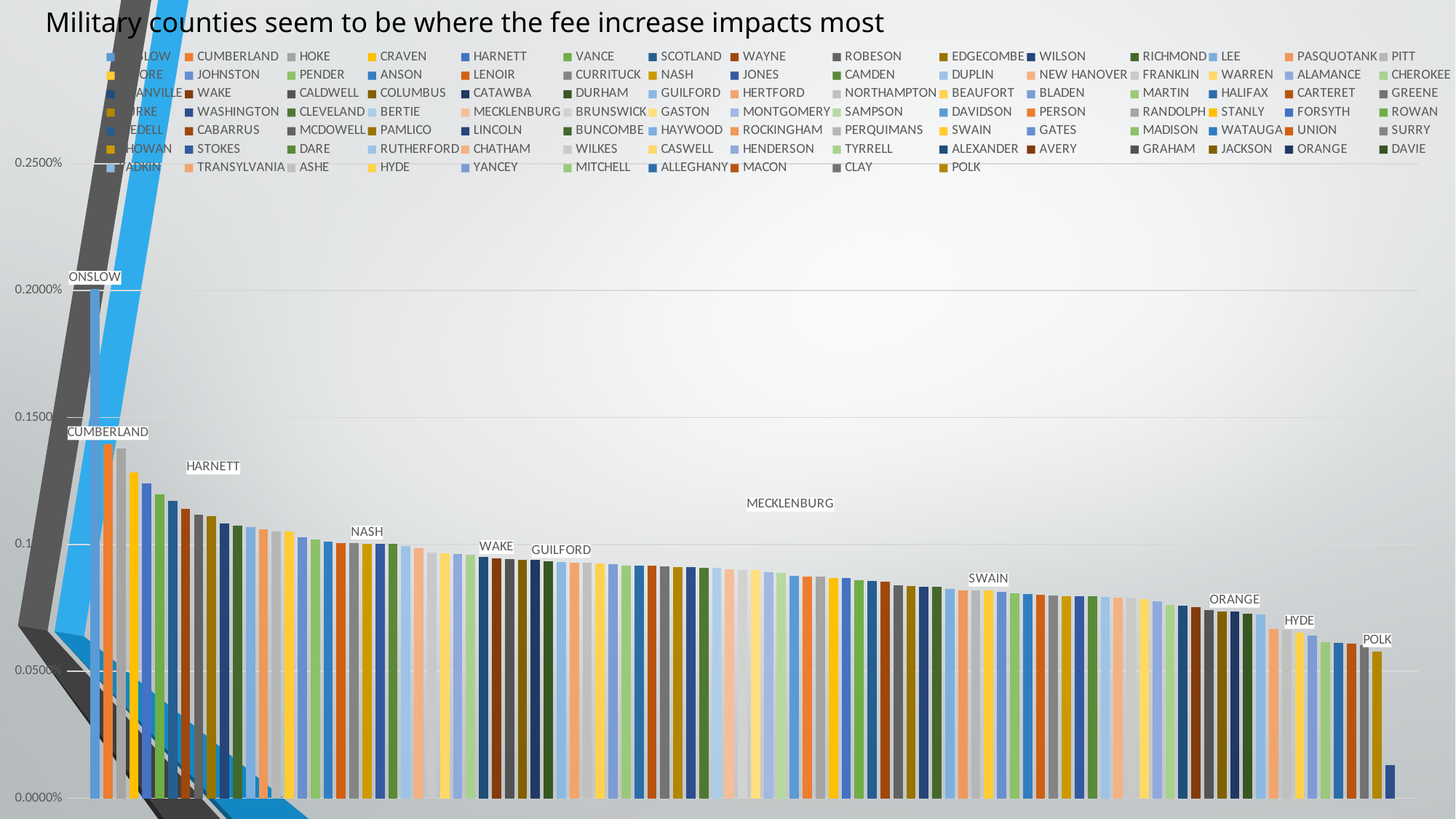
Which has the larger value, SWAIN or POLK? SWAIN Which county has the highest value in the chart? ONSLOW Is the value for POLK greater or less than 0.0500%? greater Is the value for CUMBERLAND greater or less than 0.1500%? less Is the value for ONSLOW greater or less than 0.1500%? greater Which has the larger value, CUMBERLAND or HARNETT? CUMBERLAND Which has the larger value, ONSLOW or CUMBERLAND? ONSLOW What is the title of the chart on the slide? Military counties seem to be where the fee increase impacts most Do the bar values generally rise or fall from left to right along the x axis? fall What kind of chart is shown on the slide? bar chart What is the highest value shown on the y axis of the chart? 0.2500%